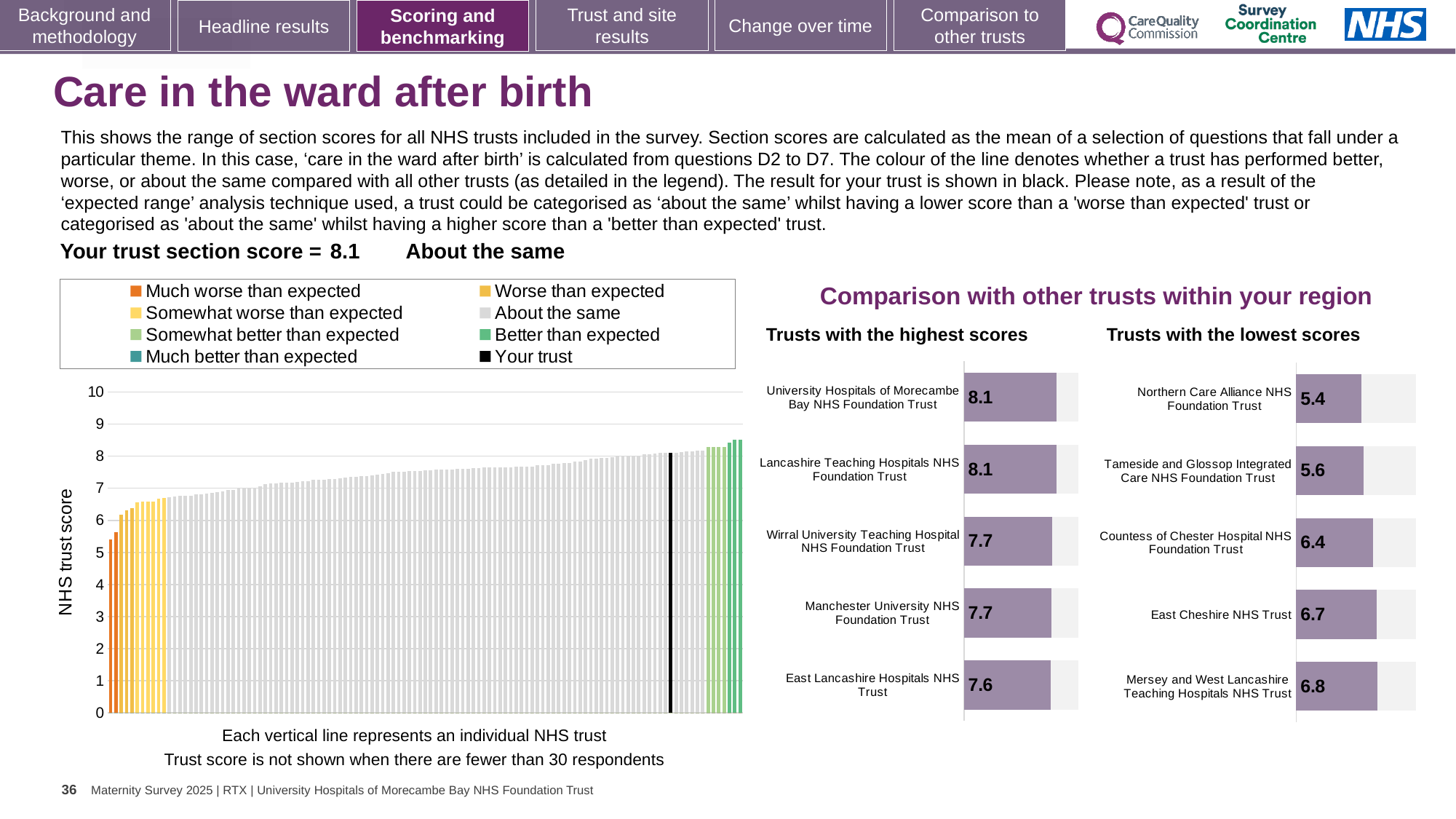
How many entries does the legend of the NHS trust score chart list? 8 In the 'Trusts with the highest scores' chart, what is the difference between the scores of Lancashire Teaching Hospitals NHS Foundation Trust and East Lancashire Hospitals NHS Trust? 0.5 In the 'Trusts with the lowest scores' chart, what is the score for Countess of Chester Hospital NHS Foundation Trust? 6.4 In the 'Trusts with the highest scores' chart, which trust has the lowest score shown? East Lancashire Hospitals NHS Trust In the 'Trusts with the highest scores' chart, what is the score for Wirral University Teaching Hospital NHS Foundation Trust? 7.7 In the NHS trust score chart, is the value of the black bar (your trust) greater or less than 7? greater In the NHS trust score chart, do the values rise or fall from left to right? Rise In the 'Trusts with the lowest scores' chart, what is the difference between the scores of Mersey and West Lancashire Teaching Hospitals NHS Trust and Northern Care Alliance NHS Foundation Trust? 1.4 How many trusts are listed in the 'Trusts with the highest scores' chart? 5 In the 'Trusts with the lowest scores' chart, which trust has the lowest score? Northern Care Alliance NHS Foundation Trust In the 'Trusts with the lowest scores' chart, which has the higher score: Tameside and Glossop Integrated Care NHS Foundation Trust or East Cheshire NHS Trust? East Cheshire NHS Trust What kind of chart is the NHS trust score chart on the left of the slide? Bar chart